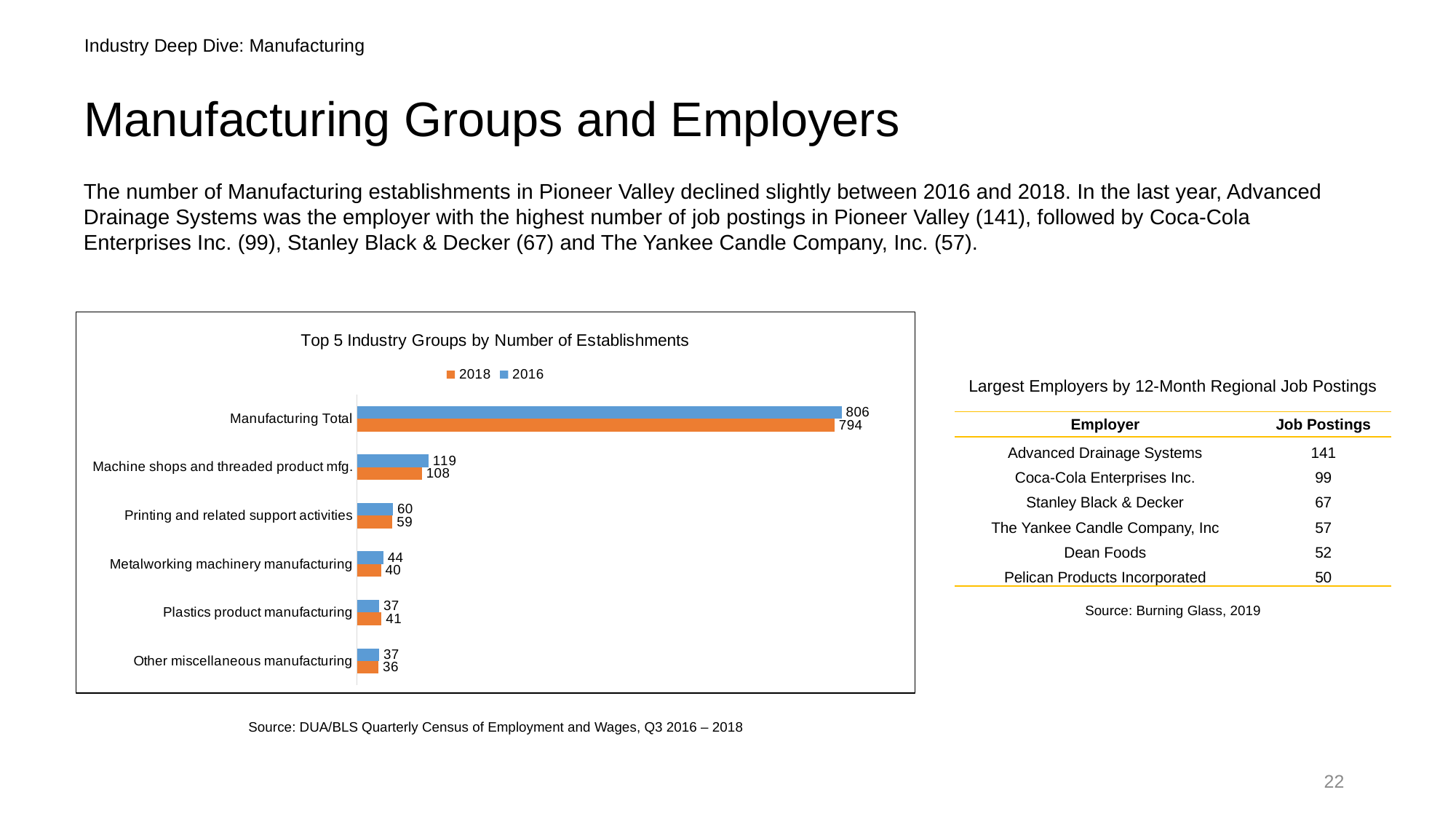
Which industry group had the lowest number of establishments in 2018? Other miscellaneous manufacturing What was the number of establishments for Plastics product manufacturing in 2018? 41 What was the number of establishments for Printing and related support activities in 2016? 60 What type of chart is used to show the Top 5 Industry Groups by Number of Establishments? Bar chart For Plastics product manufacturing, which year had more establishments, 2016 or 2018? 2018 What is the difference between the 2016 and 2018 values for Metalworking machinery manufacturing? 4 How many industry group categories are shown in the chart? 6 By how much did the Manufacturing Total number of establishments change from 2016 to 2018? 12 What was the Manufacturing Total number of establishments in 2018? 794 How many series does the chart legend list? 2 Excluding the Manufacturing Total, which industry group had the highest number of establishments in 2018? Machine shops and threaded product mfg. What was the number of establishments for Machine shops and threaded product mfg. in 2016? 119